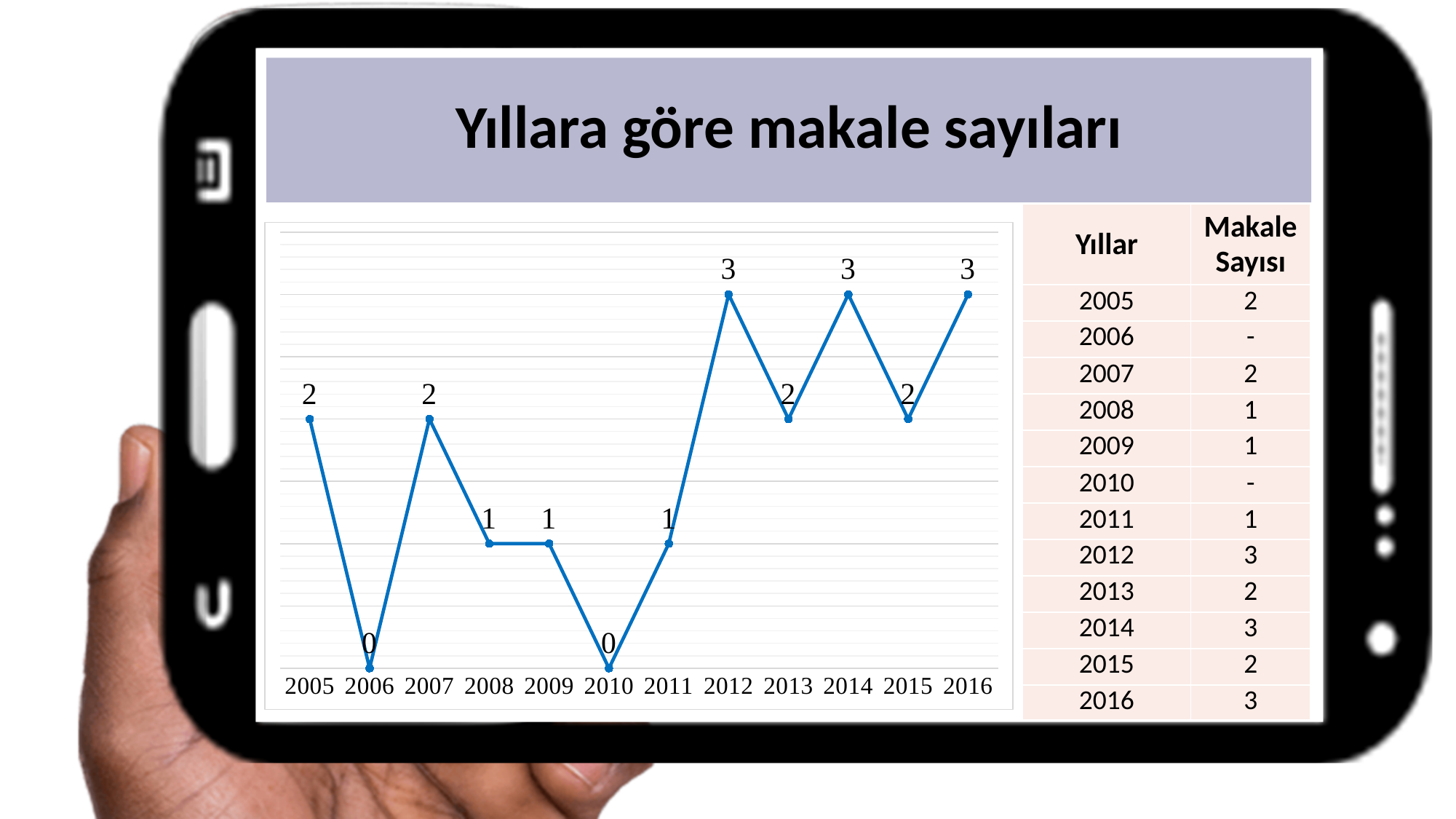
What is the title of the slide above the chart? Yıllara göre makale sayıları How many years are plotted on the x axis of the chart? 12 What is the value plotted for 2012? 3 What is the value plotted for 2008? 1 Which year has the larger value, 2007 or 2009? 2007 What is the highest value shown on the line chart? 3 What kind of chart is shown on the slide? line chart Do the values rise or fall from 2010 to 2012? rise What is the difference between the values for 2012 and 2011? 2 Which years have the lowest value on the line chart? 2006 and 2010 What is the value plotted for 2006? 0 What is the value plotted for 2015? 2